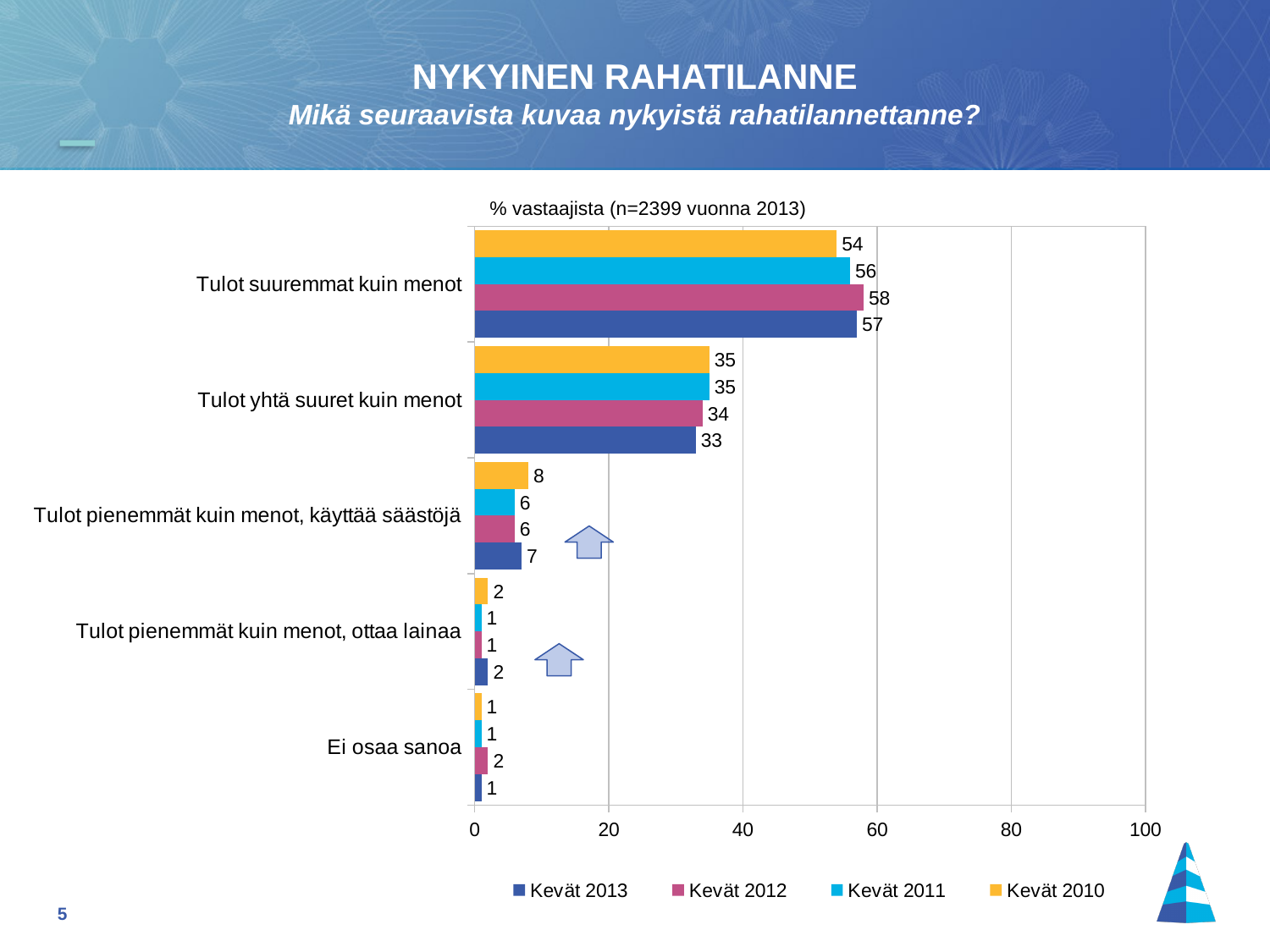
What is the value for "Ei osaa sanoa" in the Kevät 2012 series? 2 How many series does the legend list? 4 What is the value for "Tulot pienemmät kuin menot, käyttää säästöjä" in the Kevät 2012 series? 6 Which series has the highest value for "Tulot suuremmat kuin menot"? Kevät 2012 What is the difference between the Kevät 2012 and Kevät 2010 values for "Tulot suuremmat kuin menot"? 4 Which category has the highest value in the Kevät 2013 series? Tulot suuremmat kuin menot What is the value for "Tulot yhtä suuret kuin menot" in the Kevät 2010 series? 35 What is the maximum value shown on the x axis? 100 What is the value for "Tulot suuremmat kuin menot" in the Kevät 2013 series? 57 What kind of chart is shown on the slide? Bar chart Which is larger for "Tulot yhtä suuret kuin menot": the Kevät 2011 value or the Kevät 2013 value? Kevät 2011 How many categories are shown on the chart? 5